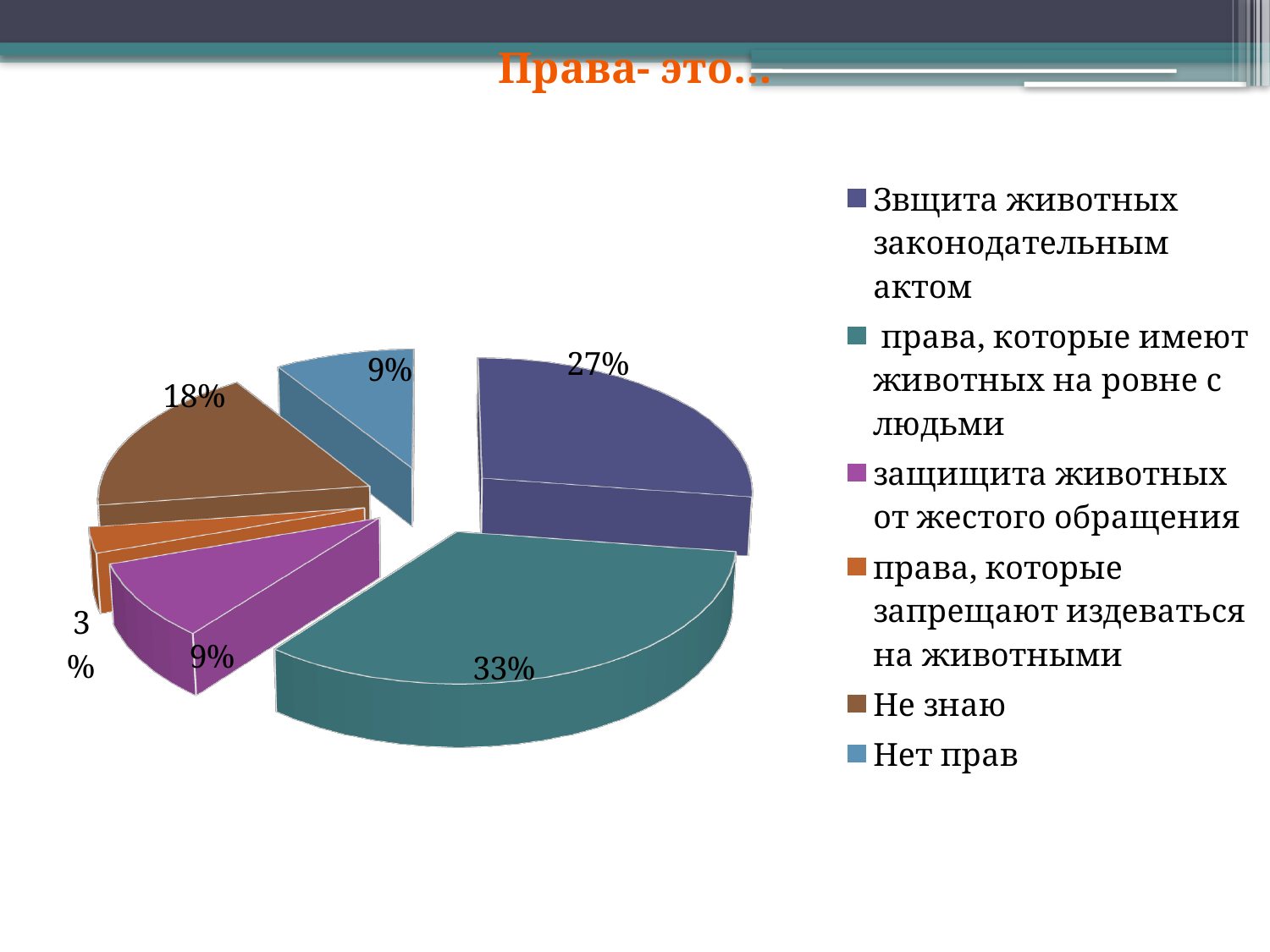
What share of the pie does "Нет прав" have? 9% Which category has the smallest slice of the pie? права, которые запрещают издеваться на животными What kind of chart is shown on the slide? pie chart How many categories does the pie chart have? 6 What share of the pie does "права, которые запрещают издеваться на животными" have? 3% What share of the pie does "Не знаю" have? 18% What share of the pie does "Звщита животных законодательным актом" have? 27% Which is larger: the share for "Не знаю" or the share for "Нет прав"? Не знаю What is the difference between the shares for "права, которые имеют животных на ровне с людьми" and "Звщита животных законодательным актом"? 6% What is the title of the slide with the pie chart? Права- это... What colour is the slice for "Не знаю"? brown Which category has the largest slice of the pie? права, которые имеют животных на ровне с людьми